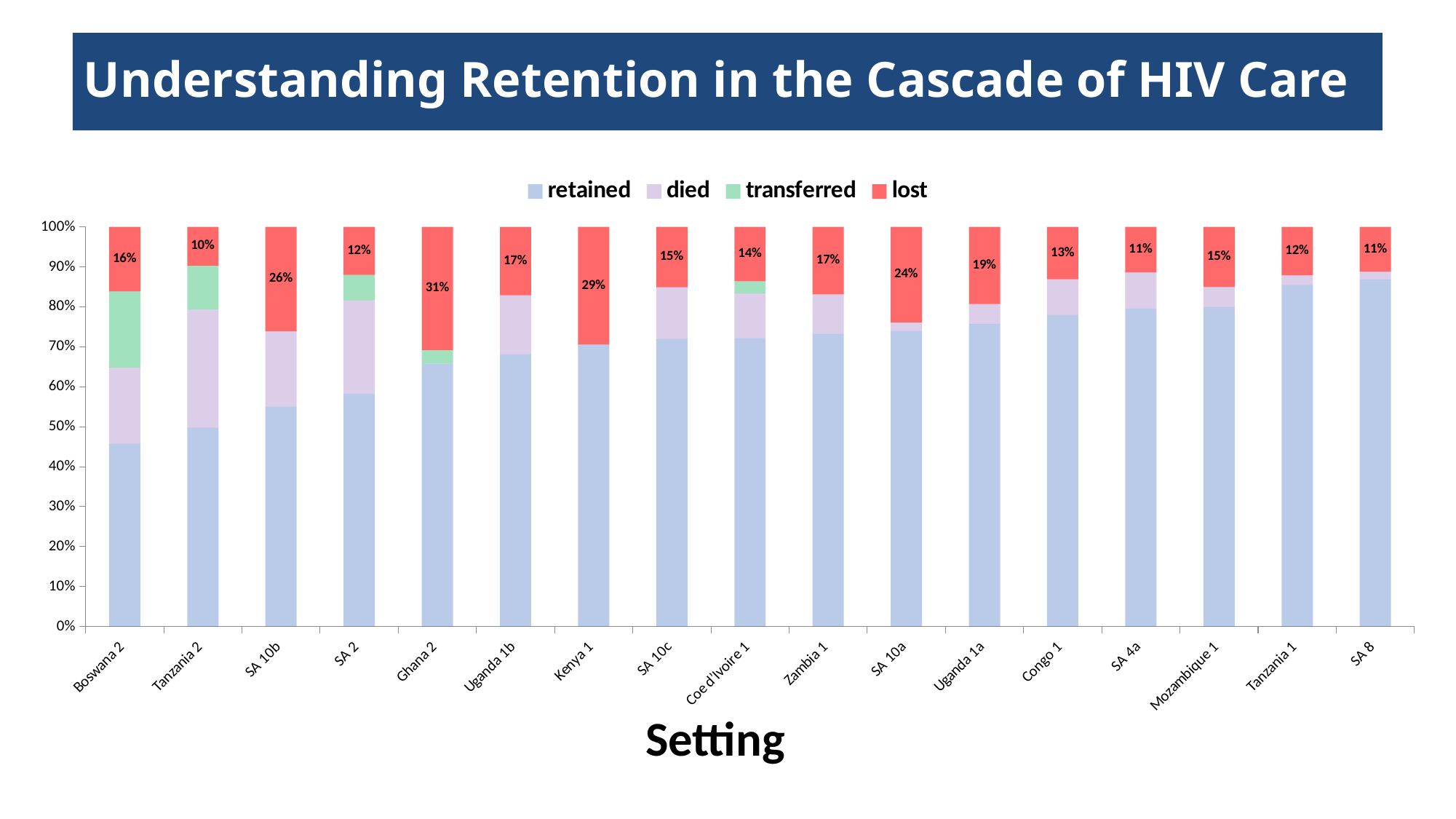
Is the retained value for Boswana 2 greater or less than 50%? less What is the difference between the lost percentage for Kenya 1 and for Congo 1? 16% What is the lost percentage for Tanzania 2? 10% What is the lost percentage for Ghana 2? 31% How many series does the legend list? 4 Does the retained share rise or fall moving left to right along the x axis? rise Is the retained value for SA 8 greater or less than 80%? greater How many settings are shown on the x axis? 17 Which has a larger lost percentage, SA 10a or Uganda 1a? SA 10a What is the lost percentage for SA 10b? 26% Which setting has the highest lost percentage? Ghana 2 Which setting has the lowest lost percentage? Tanzania 2